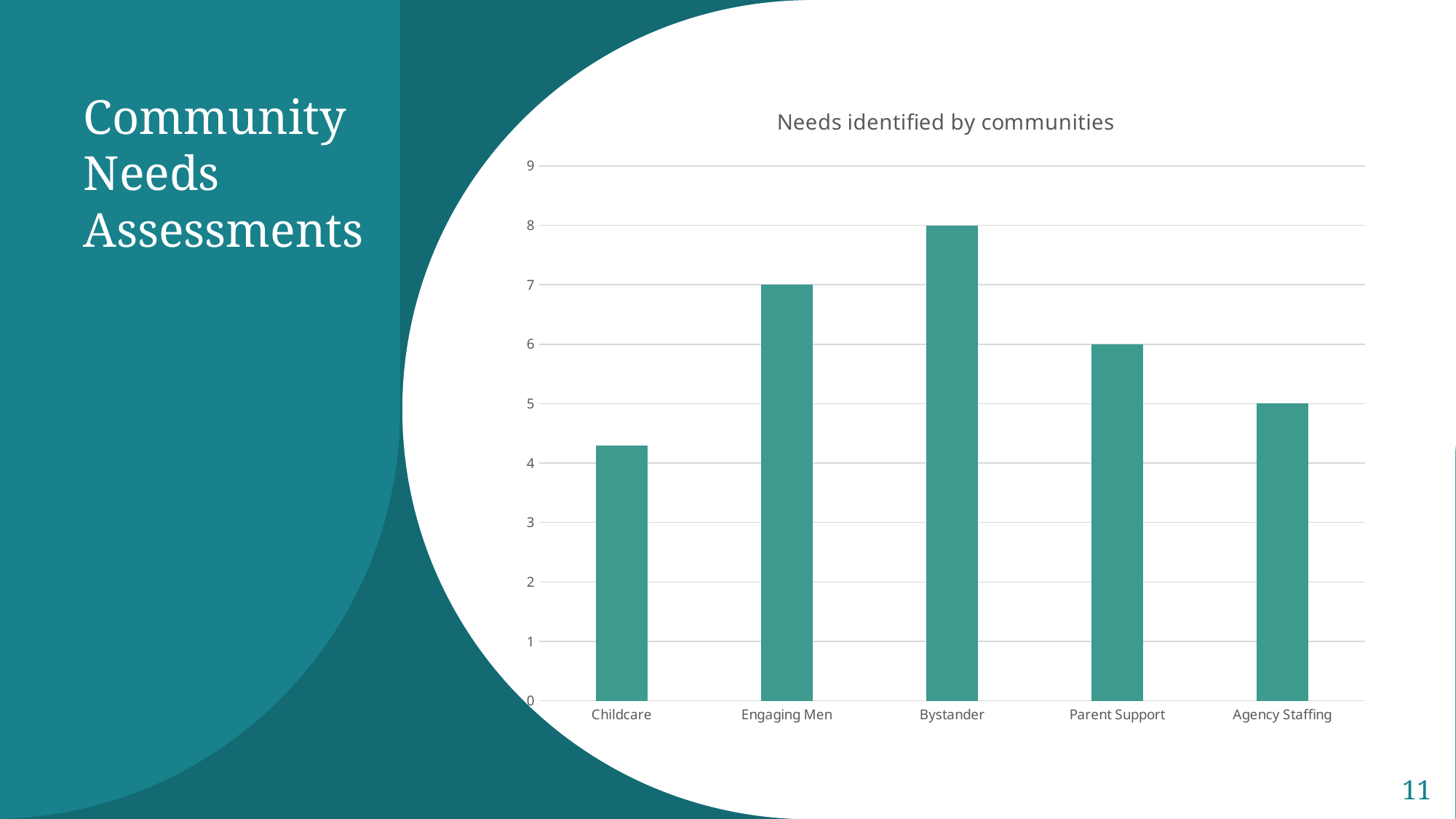
What is the value for Parent Support? 6 Which is larger, the value for Engaging Men or the value for Agency Staffing? Engaging Men Which category has the lowest value? Childcare What is the value for Engaging Men? 7 What kind of chart is shown on the slide? Bar chart Is the value for Childcare greater or less than 5? less What is the value for Agency Staffing? 5 How many categories are shown on the x axis? 5 Which category has the highest value? Bystander What is the title of the chart? Needs identified by communities What is the difference between the values for Bystander and Parent Support? 2 What is the value for Bystander? 8